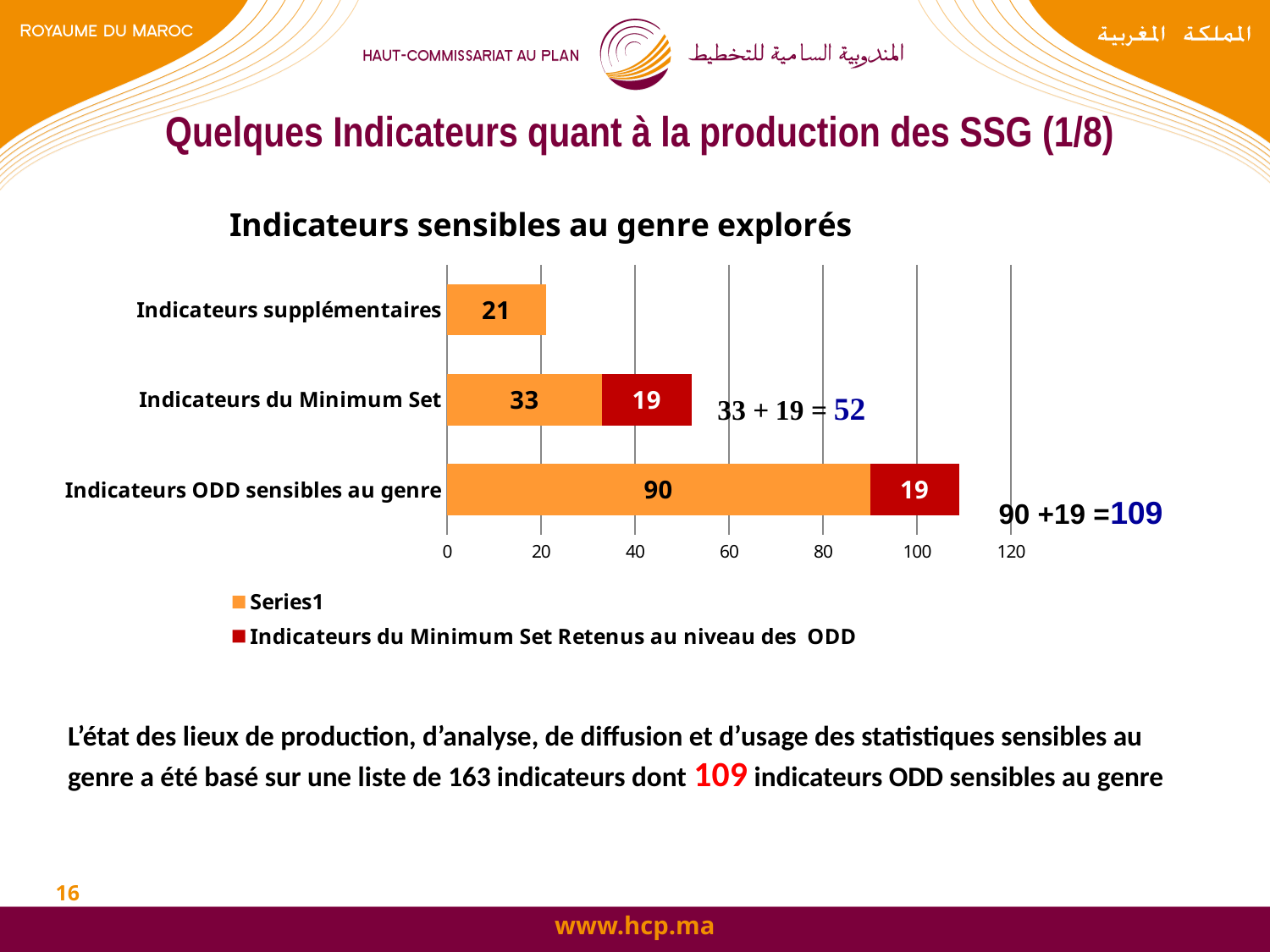
Which category has the highest Series1 value? Indicateurs ODD sensibles au genre What is the difference between the Series1 values for Indicateurs ODD sensibles au genre and Indicateurs du Minimum Set? 57 What is the Series1 value for Indicateurs ODD sensibles au genre? 90 How many categories are shown on the chart? 3 Which is larger: the Series1 value for Indicateurs du Minimum Set or for Indicateurs supplémentaires? Indicateurs du Minimum Set What is the value of 'Indicateurs du Minimum Set Retenus au niveau des ODD' for Indicateurs du Minimum Set? 19 What is the Series1 value for Indicateurs supplémentaires? 21 How many series does the legend list? 2 Which category has the lowest Series1 value? Indicateurs supplémentaires What is the total of the stacked bar for Indicateurs ODD sensibles au genre? 109 What kind of chart is shown on the slide? Stacked bar chart What is the total of the stacked bar for Indicateurs du Minimum Set? 52